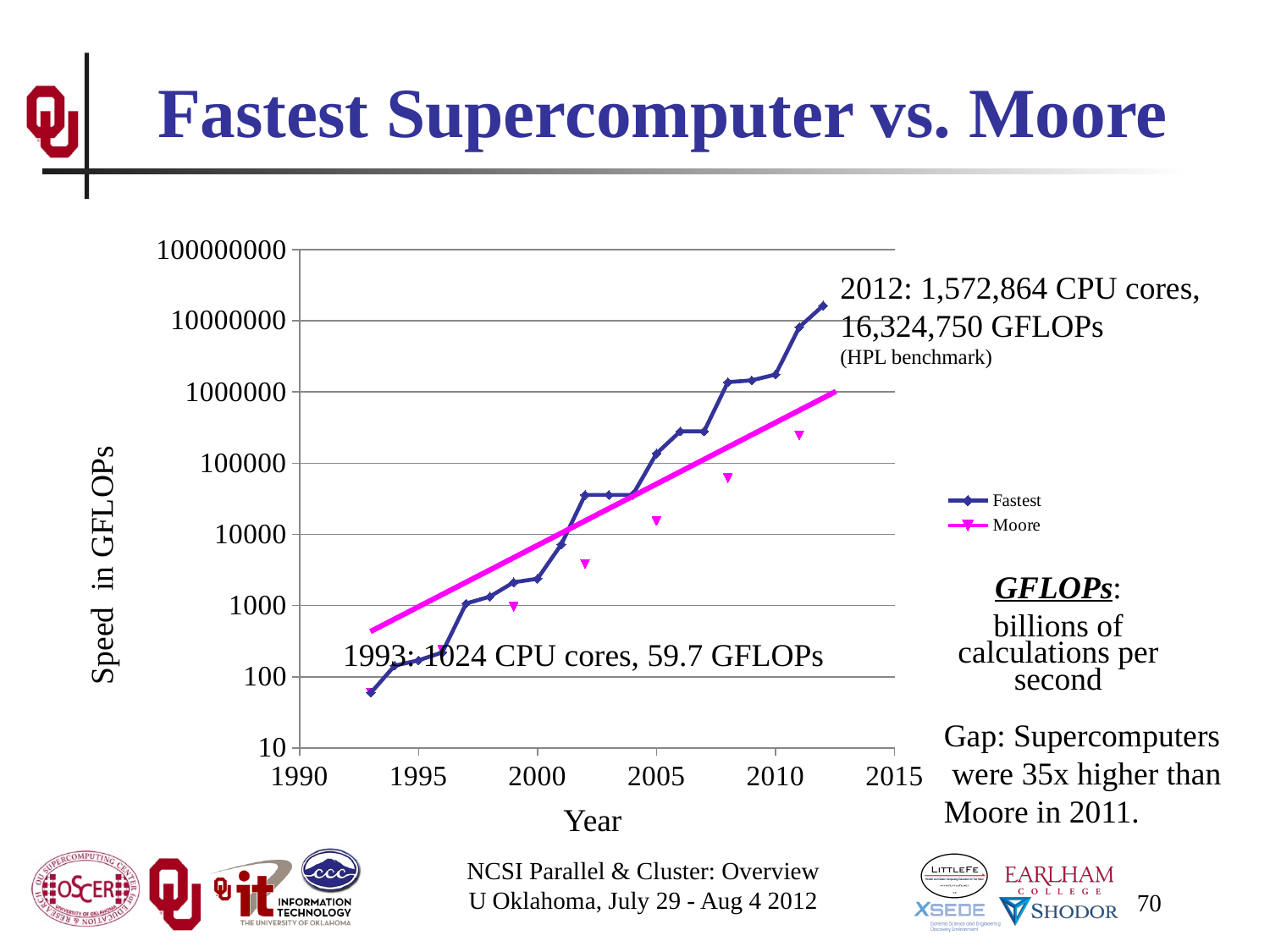
Does the Fastest series rise or fall as the year increases? rise Is the value for Fastest in 2010 greater or less than 1000000? greater What is the label of the y axis? Speed in GFLOPs How many series does the legend list? 2 In which year does the Fastest series have its lowest value? 1993 What are the two series named in the legend? Fastest and Moore What kind of chart is shown on the slide? line chart What was the speed of the fastest supercomputer in 2012, as printed on the slide? 16,324,750 GFLOPs How many CPU cores did the fastest supercomputer have in 2012? 1,572,864 What was the speed of the fastest supercomputer in 1993, as printed on the slide? 59.7 GFLOPs In which year does the Fastest series reach its highest value? 2012 In 2011, which series has the larger value, Fastest or Moore? Fastest